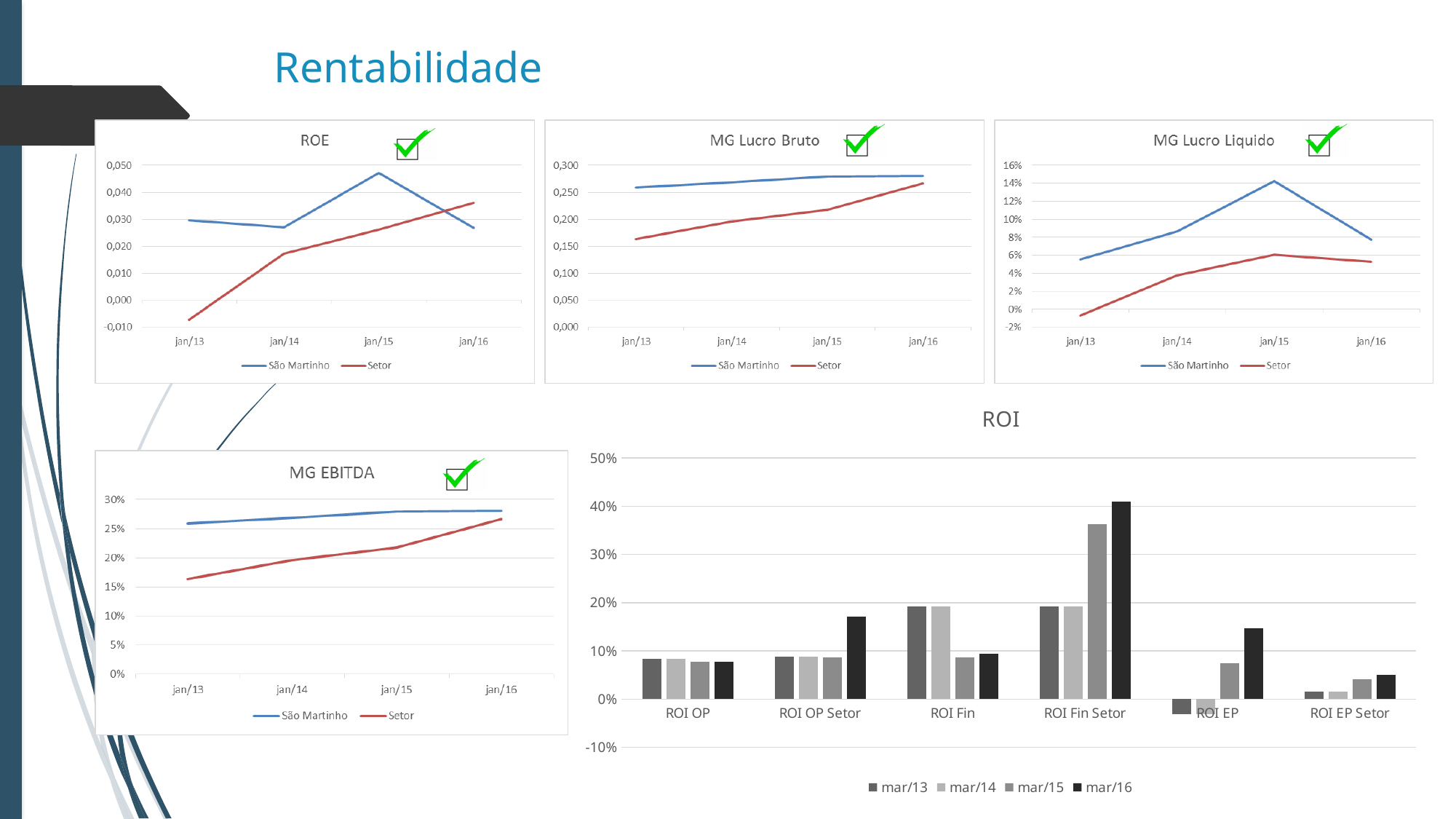
In the ROI chart, is the mar/13 value for ROI EP greater or less than 0%? less How many categories are shown on the x axis of the ROI chart? 6 In the MG Lucro Liquido chart, at which date does the São Martinho line reach its highest value? jan/15 In the ROE chart, which series has the higher value at jan/16? Setor In the MG Lucro Bruto chart, does the Setor line rise or fall from jan/13 to jan/16? rises In the ROE chart, which series has the higher value at jan/15? São Martinho In the ROI chart, is the mar/16 value for ROI Fin Setor greater or less than 30%? greater How many series does the legend of the MG EBITDA chart list? 2 How many series does the legend of the ROI chart list? 4 What kind of chart is the ROI chart? bar chart In the ROI chart, is the mar/16 value for ROI OP Setor greater or less than 10%? greater In the ROI chart, which category contains the tallest bar? ROI Fin Setor